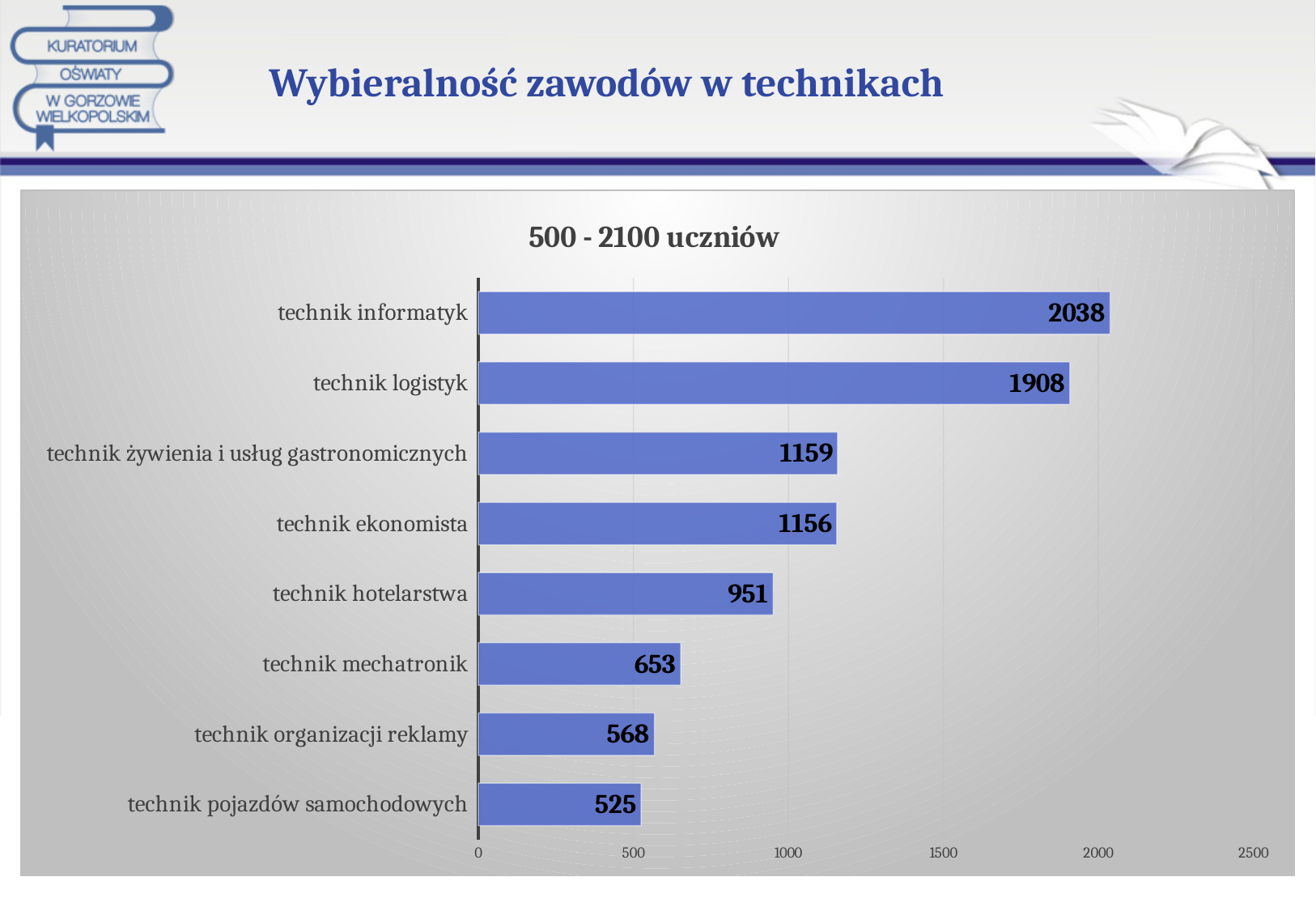
How many categories are shown in the chart? 8 What is the difference between the values for technik informatyk and technik logistyk? 130 What is the difference between the values for technik mechatronik and technik pojazdów samochodowych? 128 Which is larger, the value for technik hotelarstwa or the value for technik mechatronik? technik hotelarstwa What is the value for technik informatyk? 2038 What is the value for technik hotelarstwa? 951 What is the value for technik organizacji reklamy? 568 Is the value for technik logistyk greater or less than 1500? greater Which category has the highest value? technik informatyk Which category has the lowest value? technik pojazdów samochodowych What kind of chart is shown on the slide? bar chart What is the title of the chart? 500 - 2100 uczniów